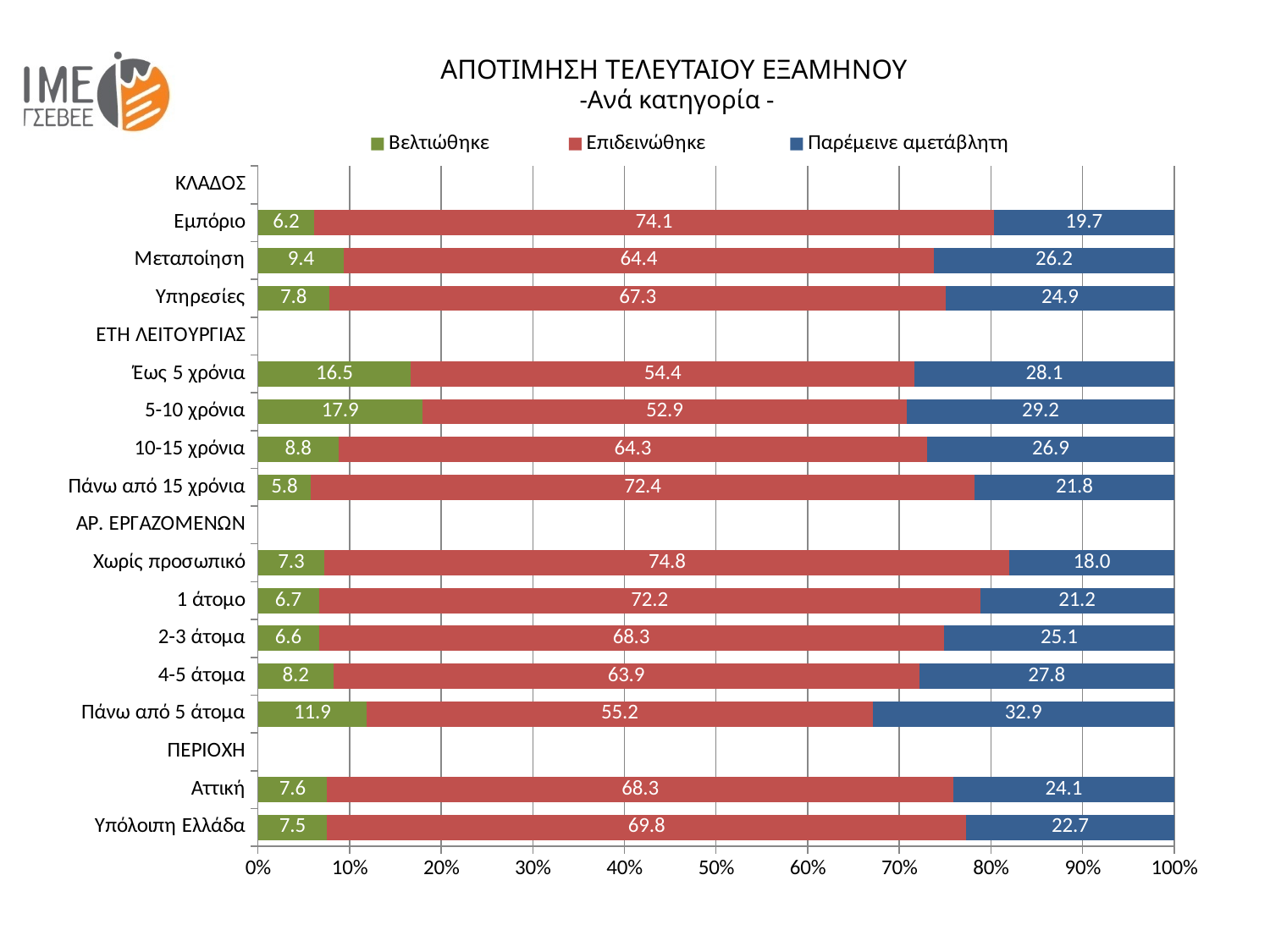
What is the difference between the Επιδεινώθηκε values for Εμπόριο and Μεταποίηση? 9.7 What is the total of the stacked bar for Πάνω από 5 άτομα? 100.0 What is the value of Παρέμεινε αμετάβλητη for Μεταποίηση? 26.2 How many series does the legend list? 3 Which has a larger Βελτιώθηκε value, Έως 5 χρόνια or 5-10 χρόνια? 5-10 χρόνια What is the value of Επιδεινώθηκε for Εμπόριο? 74.1 Which category has the highest Παρέμεινε αμετάβλητη value? Πάνω από 5 άτομα Which category has the lowest Παρέμεινε αμετάβλητη value? Χωρίς προσωπικό Which category has the lowest Βελτιώθηκε value? Πάνω από 15 χρόνια What is the value of Βελτιώθηκε for 5-10 χρόνια? 17.9 Which category has the highest Βελτιώθηκε value? 5-10 χρόνια What kind of chart is shown on the slide? Stacked bar chart